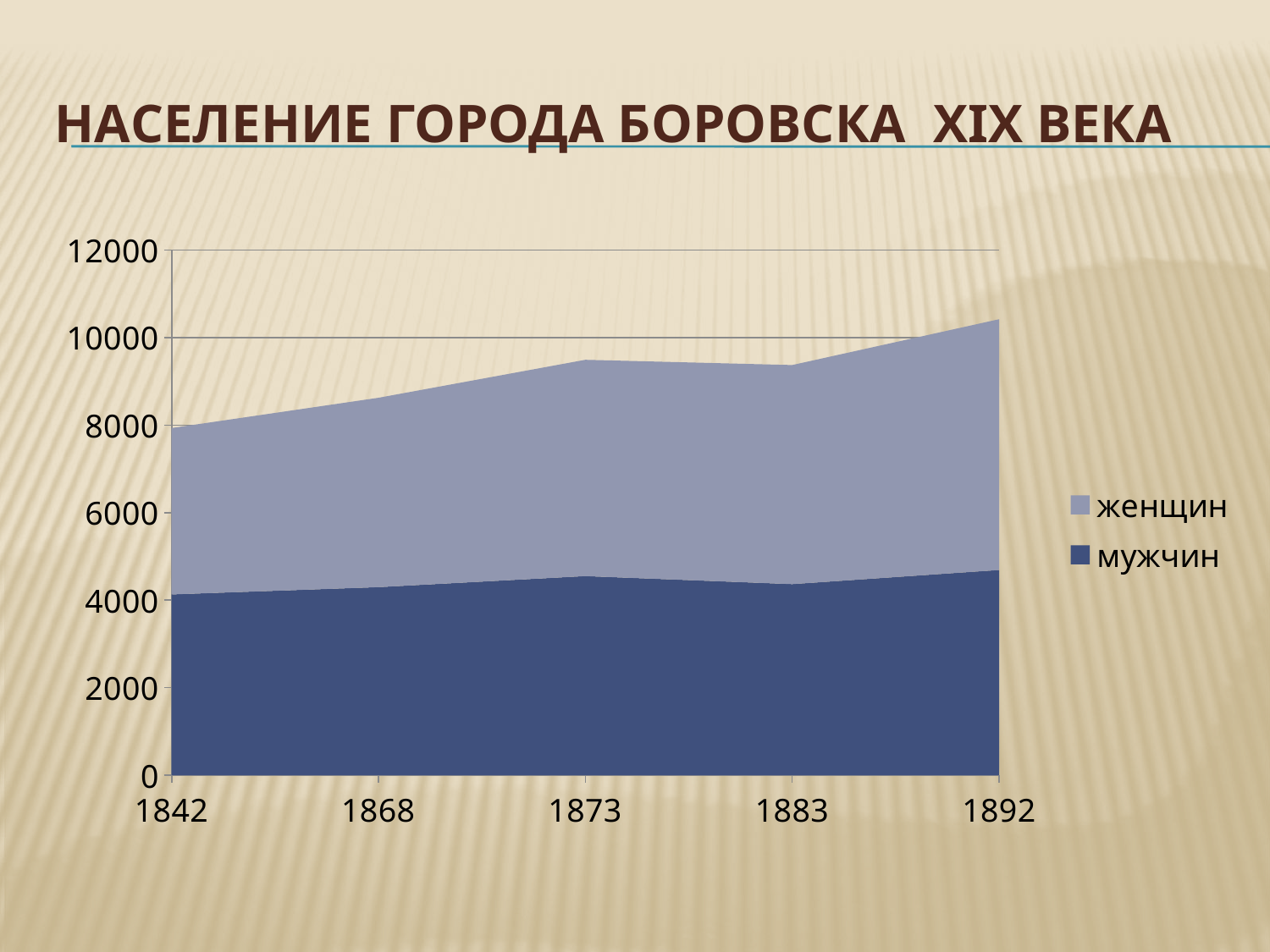
Is the value for мужчин in 1892 greater or less than 4000? greater Does the total population generally rise or fall from 1842 to 1892? rise How many years are shown on the x axis of the chart? 5 What is the title of the slide? НАСЕЛЕНИЕ ГОРОДА БОРОВСКА XIX ВЕКА In which year is the total population (top of the stacked area) highest? 1892 In which year is the total population (top of the stacked area) lowest? 1842 What kind of chart is shown on the slide? area chart Which series is shown in the darker blue colour? мужчин Is the total population in 1892 greater or less than 10000? greater How many series does the legend list? 2 Is the total population in 1868 greater or less than 10000? less